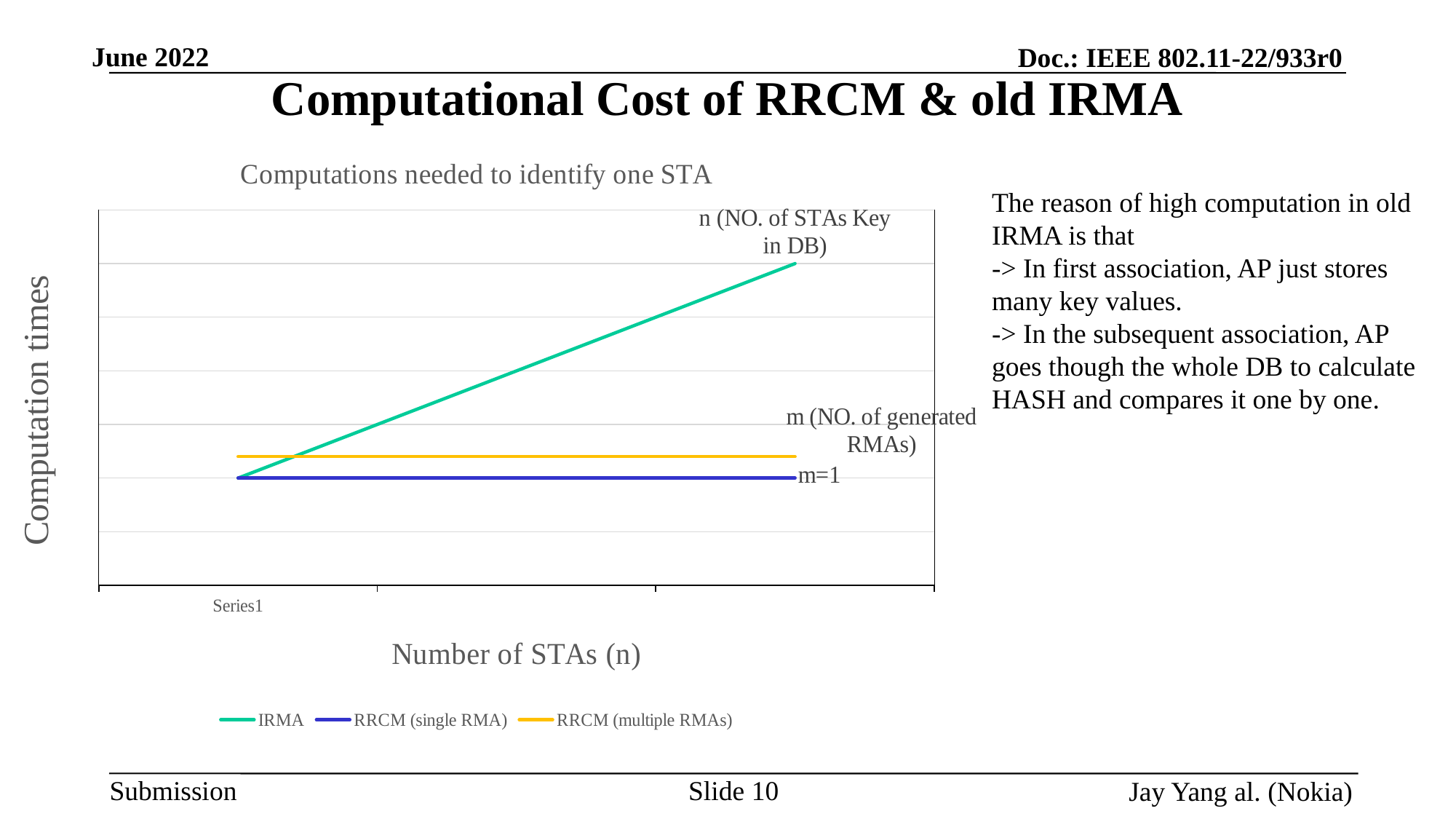
What is the x-axis title of the chart? Number of STAs (n) At the right end of the chart, which series has the lowest computation times? RRCM (single RMA) At the right end of the chart, which is higher: RRCM (multiple RMAs) or RRCM (single RMA)? RRCM (multiple RMAs) What data label is shown at the end of the RRCM (single RMA) line? m=1 What data label is shown at the end of the IRMA line? n (NO. of STAs Key in DB) At the right end of the chart, which series has the highest computation times? IRMA Does the RRCM (single RMA) line rise, fall, or stay flat as the number of STAs increases? Stays flat What kind of chart is shown on the slide? Line chart How many series does the legend list? 3 Does the IRMA line rise or fall as the number of STAs increases? Rises What is the title of the chart? Computations needed to identify one STA Does the RRCM (multiple RMAs) line rise, fall, or stay flat as the number of STAs increases? Stays flat